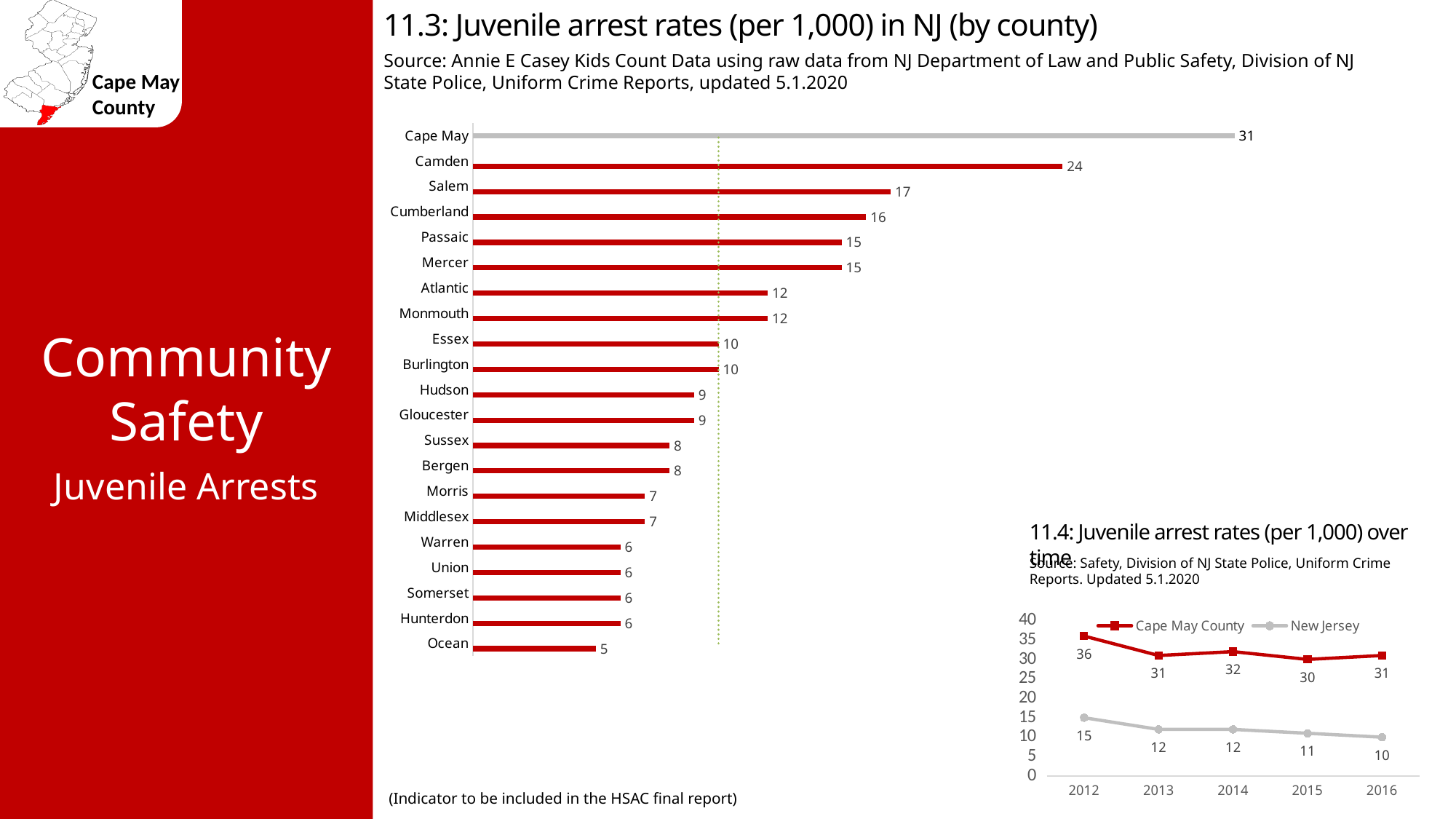
In the chart '11.3: Juvenile arrest rates (per 1,000) in NJ (by county)', what is the value for Camden? 24 In the chart '11.4: Juvenile arrest rates (per 1,000) over time', what is the value for New Jersey in 2016? 10 In the chart '11.3: Juvenile arrest rates (per 1,000) in NJ (by county)', how many counties are shown? 21 In the chart '11.4: Juvenile arrest rates (per 1,000) over time', what is the value for Cape May County in 2012? 36 What kind of chart is '11.3: Juvenile arrest rates (per 1,000) in NJ (by county)'? bar chart In the chart '11.4: Juvenile arrest rates (per 1,000) over time', what is the difference between Cape May County and New Jersey in 2014? 20 In the chart '11.4: Juvenile arrest rates (per 1,000) over time', how many series does the legend list? 2 In the chart '11.3: Juvenile arrest rates (per 1,000) in NJ (by county)', which is larger, the value for Salem or the value for Atlantic? Salem In the chart '11.3: Juvenile arrest rates (per 1,000) in NJ (by county)', which county has the highest value? Cape May In the chart '11.3: Juvenile arrest rates (per 1,000) in NJ (by county)', which county has the lowest value? Ocean In the chart '11.3: Juvenile arrest rates (per 1,000) in NJ (by county)', what is the difference between the values for Cape May and Camden? 7 In the chart '11.4: Juvenile arrest rates (per 1,000) over time', does the New Jersey series rise or fall from 2012 to 2016? fall